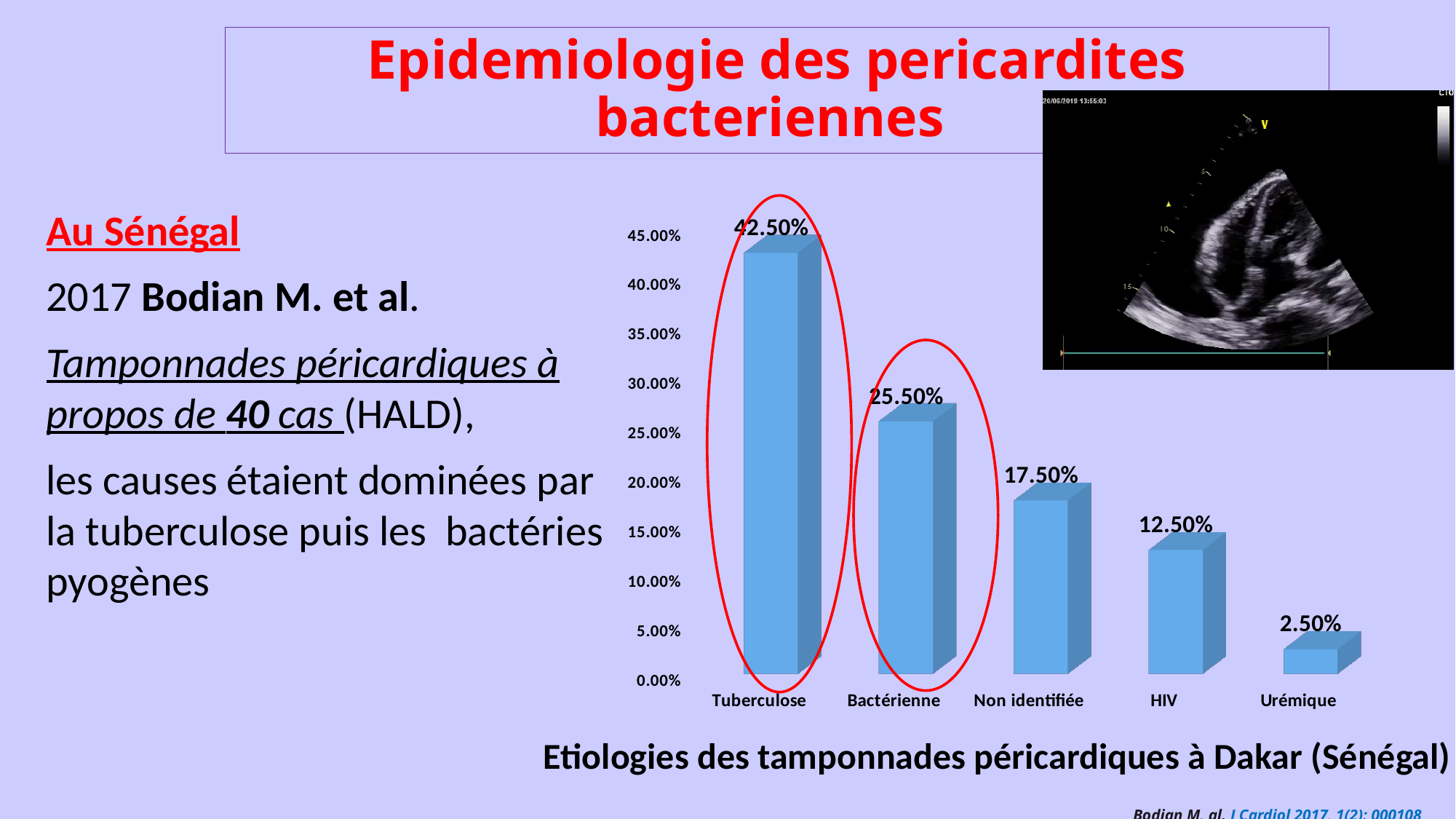
Do the values rise or fall from left to right along the x axis? Fall How many categories are shown on the x axis? 5 Which category has the lowest value? Urémique What is the value for Tuberculose? 42.50% Which category has the highest value? Tuberculose What is the value for Bactérienne? 25.50% What is the difference between the values for Tuberculose and Bactérienne? 17.00% What kind of chart is shown? Bar chart What is the value for HIV? 12.50% What is the value for Urémique? 2.50% What is the value for Non identifiée? 17.50% Which is larger, the value for Non identifiée or the value for HIV? Non identifiée